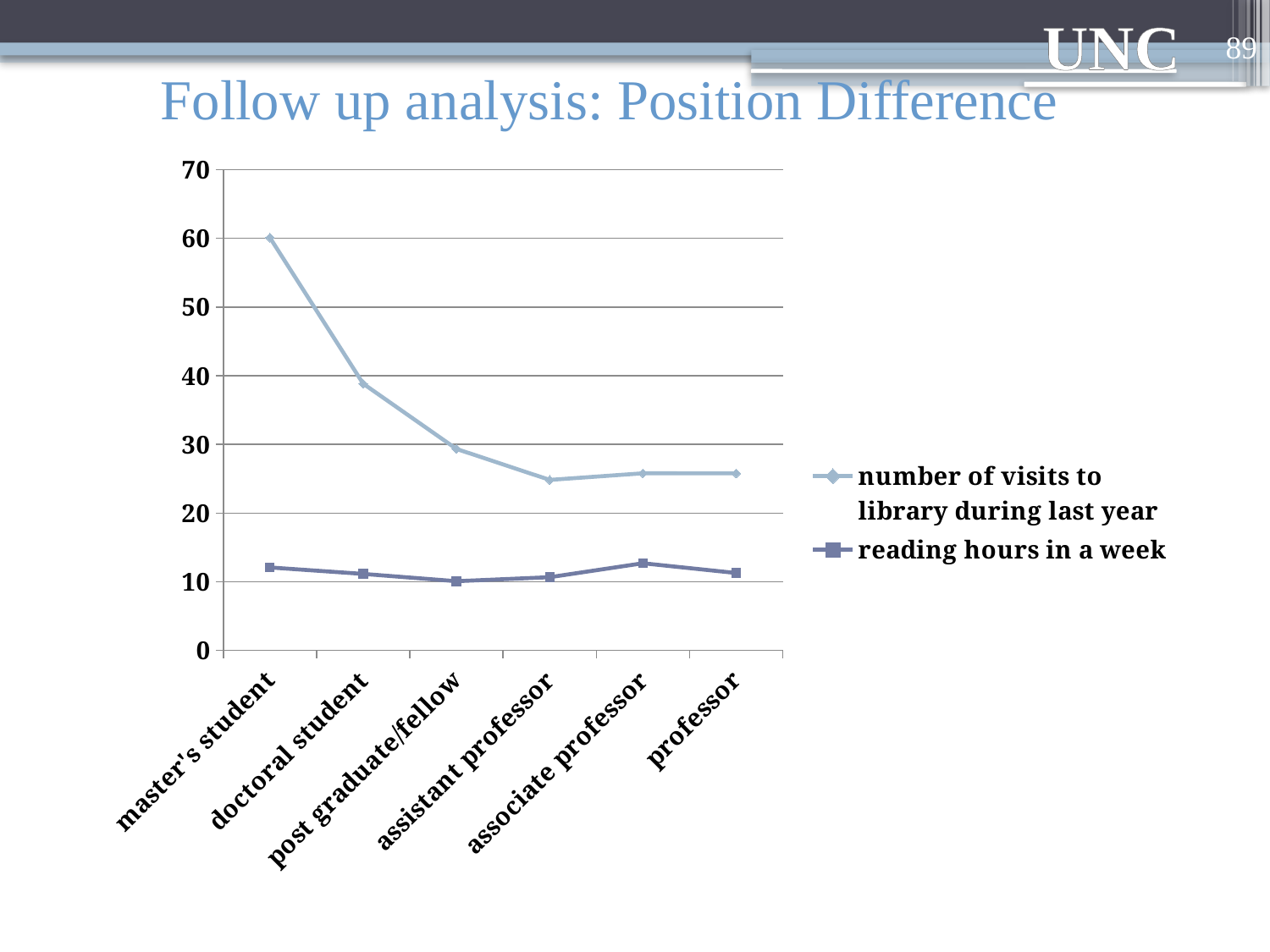
Which has more visits to library during last year: master's student or doctoral student? master's student How many position categories are shown on the x axis? 6 Which position has the highest number of visits to library during last year? master's student Is the number of visits to library during last year for assistant professor greater or less than 30? less How many series does the legend list? 2 Is the number of visits to library during last year for doctoral student greater or less than 50? less Which is larger for professor: number of visits to library during last year or reading hours in a week? number of visits to library during last year What is the title of the slide containing the chart? Follow up analysis: Position Difference Does the number of visits to library during last year rise or fall from master's student to assistant professor? fall Is the value for reading hours in a week for professor greater or less than 20? less What kind of chart is shown on the slide? line chart